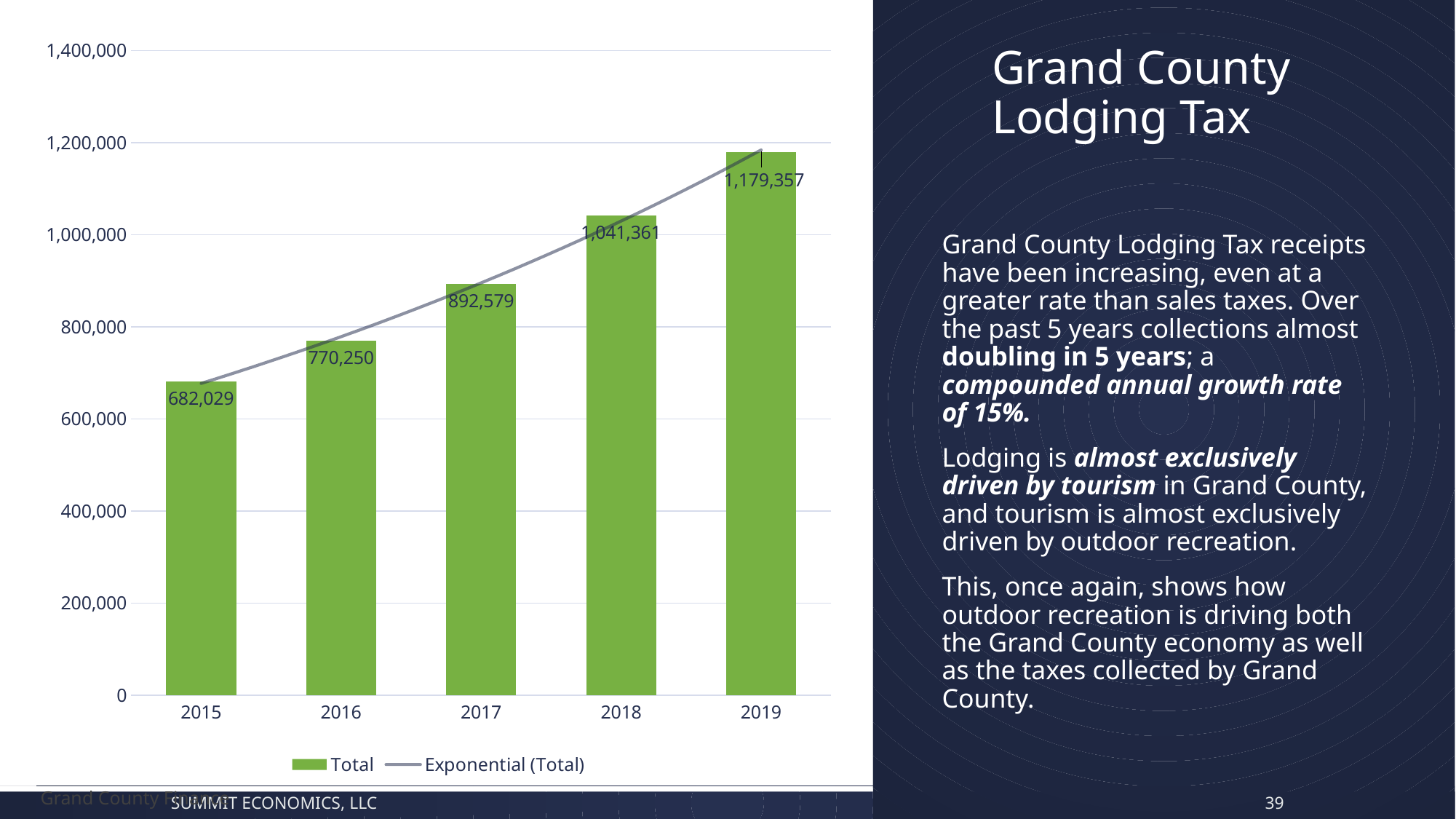
How many years are shown on the x axis? 5 Which is larger, the Total value for 2016 or for 2018? 2018 How many series does the legend list? 2 Which year has the highest Total value? 2019 Is the Total value for 2016 greater or less than 800,000? less What is the Total value for 2019? 1,179,357 Which year has the lowest Total value? 2015 Do the Total values rise or fall from 2015 to 2019? rise What is the Total value for 2017? 892,579 What is the Total value for 2015? 682,029 What is the difference between the Total values for 2019 and 2015? 497,328 What is the difference between the Total values for 2018 and 2017? 148,782